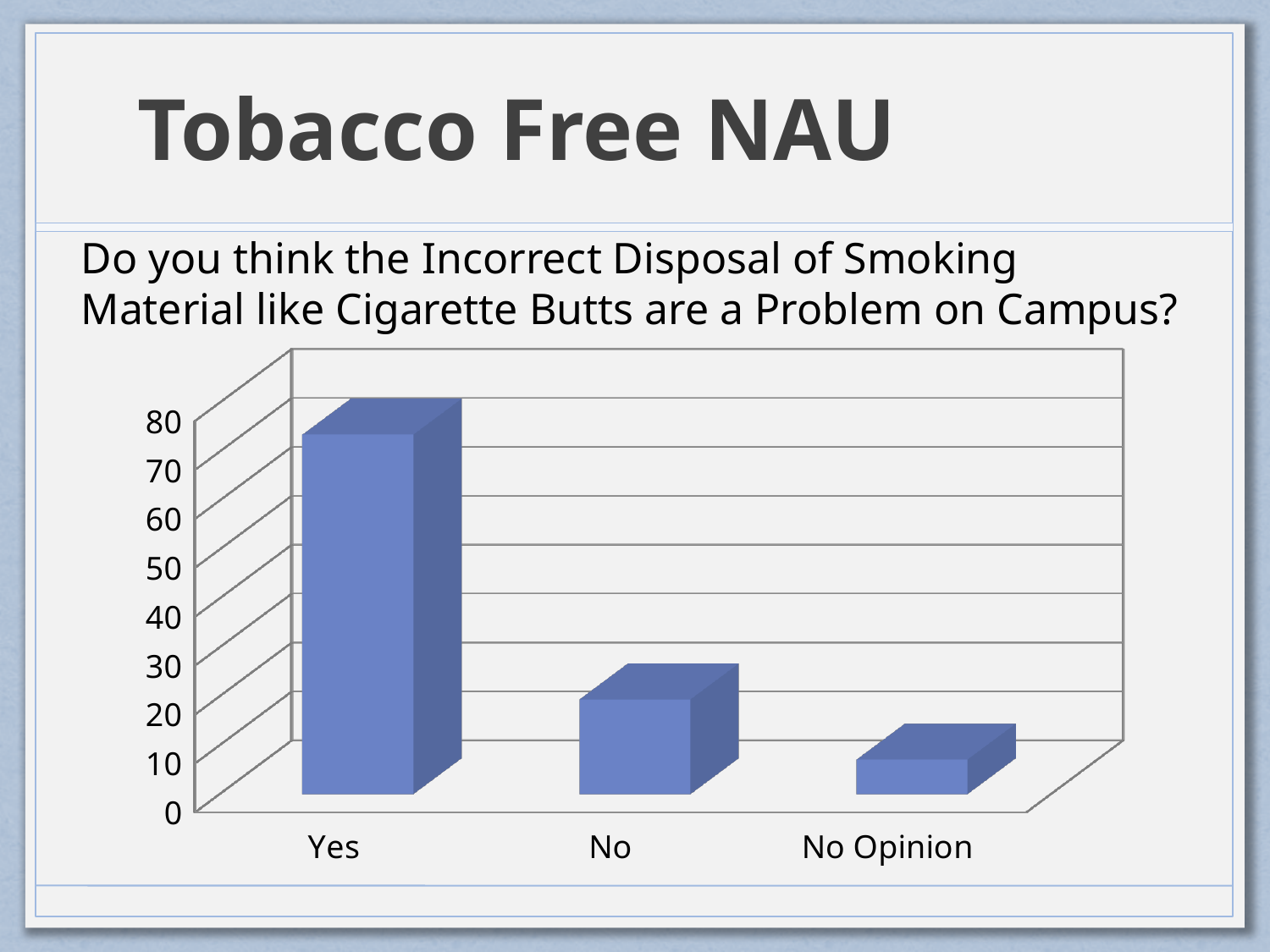
What is the highest value labelled on the vertical axis? 80 Which category has the highest bar? Yes Is the value for Yes greater or less than 60? greater What kind of chart is shown on the slide? bar chart Which is larger, the value for No or the value for No Opinion? No Is the value for No Opinion greater or less than 20? less Which is larger, the value for Yes or the value for No? Yes Which category has the lowest bar? No Opinion What question does the chart title ask? Do you think the Incorrect Disposal of Smoking Material like Cigarette Butts are a Problem on Campus? Do the bar values rise or fall moving from left to right along the x axis? fall Is the value for No greater or less than 40? less How many categories are shown on the x axis of the chart? 3